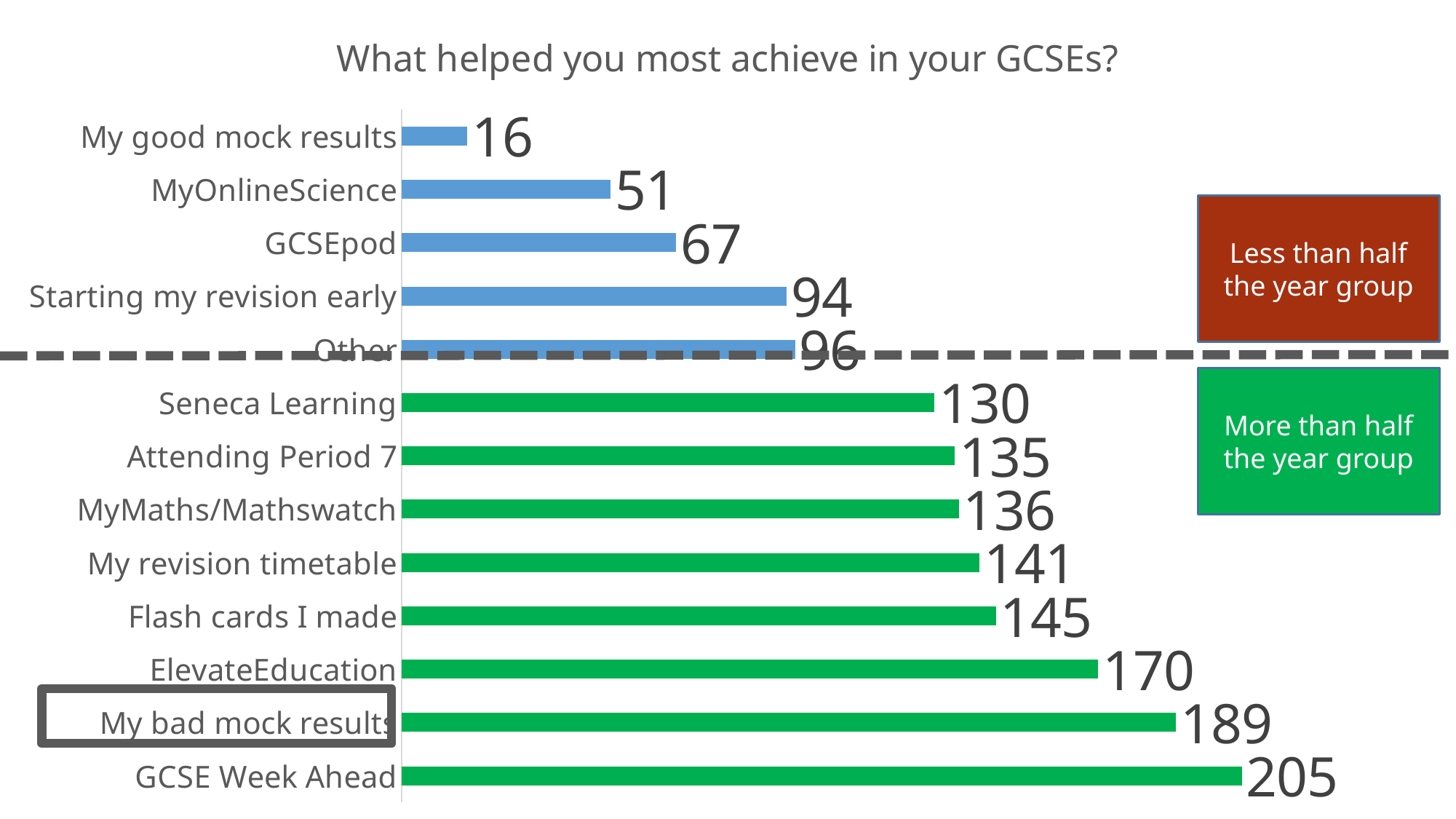
Which is larger, the value for Flash cards I made or the value for MyOnlineScience? Flash cards I made How many categories are shown in the chart? 13 What is the title of the chart? What helped you most achieve in your GCSEs? What is the value for My good mock results? 16 What is the difference between the values for Starting my revision early and GCSEpod? 27 Which category has the lowest value? My good mock results What is the value for Seneca Learning? 130 Which category has the highest value? GCSE Week Ahead What is the value for ElevateEducation? 170 What is the value for GCSE Week Ahead? 205 What is the difference between the values for GCSE Week Ahead and My bad mock results? 16 What kind of chart is this? Bar chart